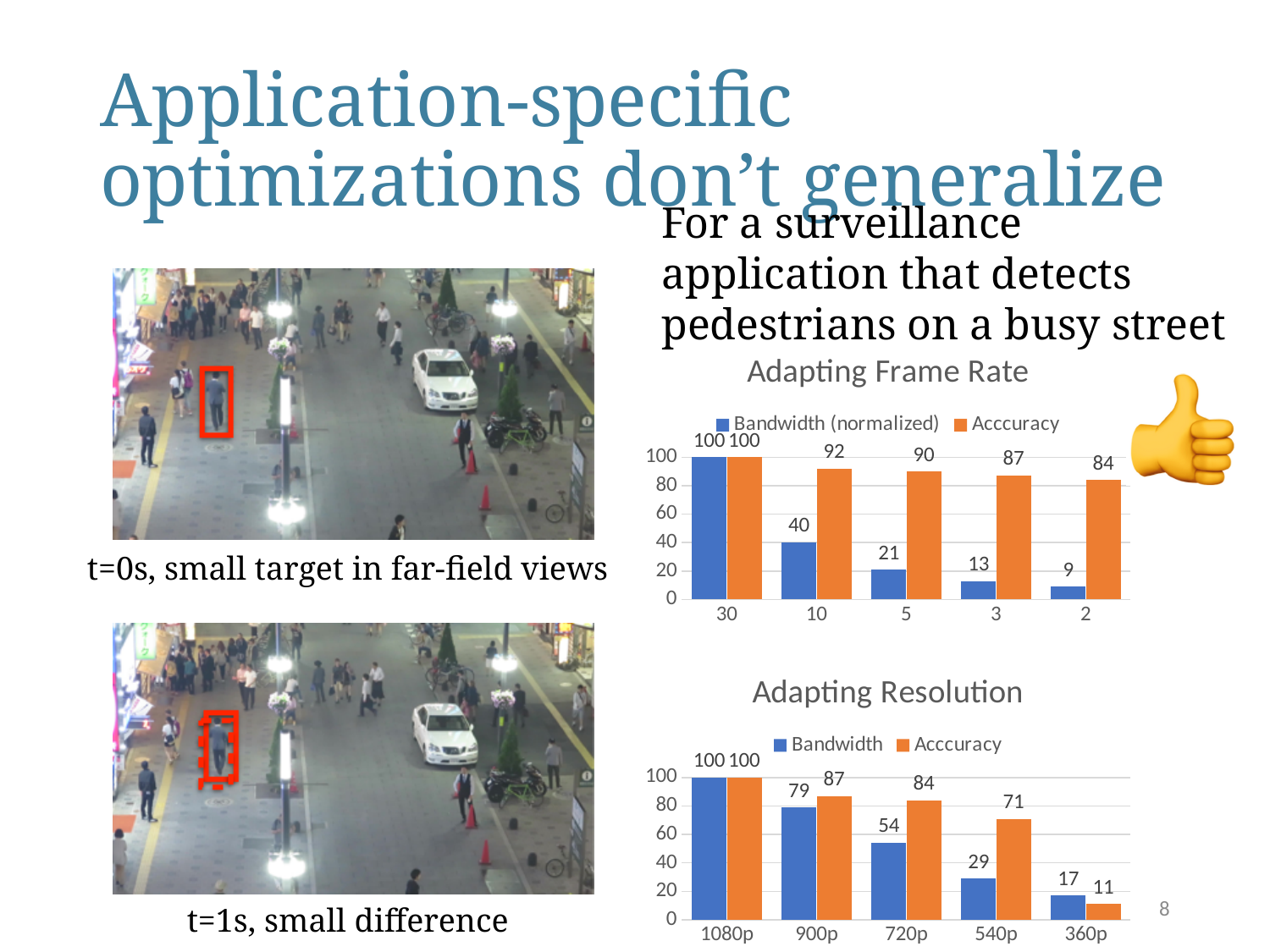
What type of chart is the 'Adapting Resolution' chart? bar chart In the 'Adapting Frame Rate' chart, how many frame rate categories are shown on the x axis? 5 In the 'Adapting Resolution' chart, what is the Accuracy value at 360p? 11 In the 'Adapting Frame Rate' chart, which frame rate has the lowest Bandwidth (normalized) value? 2 In the 'Adapting Resolution' chart, what is the difference between the Bandwidth values at 900p and 540p? 50 In the 'Adapting Frame Rate' chart, what is the Accuracy value at frame rate 2? 84 In the 'Adapting Resolution' chart, what is the Bandwidth value at 720p? 54 In the 'Adapting Frame Rate' chart, what is the difference between the Accuracy values at frame rate 30 and frame rate 5? 10 In the 'Adapting Resolution' chart, which resolution has the lowest Accuracy value? 360p In the 'Adapting Frame Rate' chart, do the Bandwidth (normalized) values rise or fall from left to right along the x axis? fall In the 'Adapting Frame Rate' chart, what is the Bandwidth (normalized) value at frame rate 10? 40 In the 'Adapting Resolution' chart, which is larger at 540p: Bandwidth or Accuracy? Accuracy